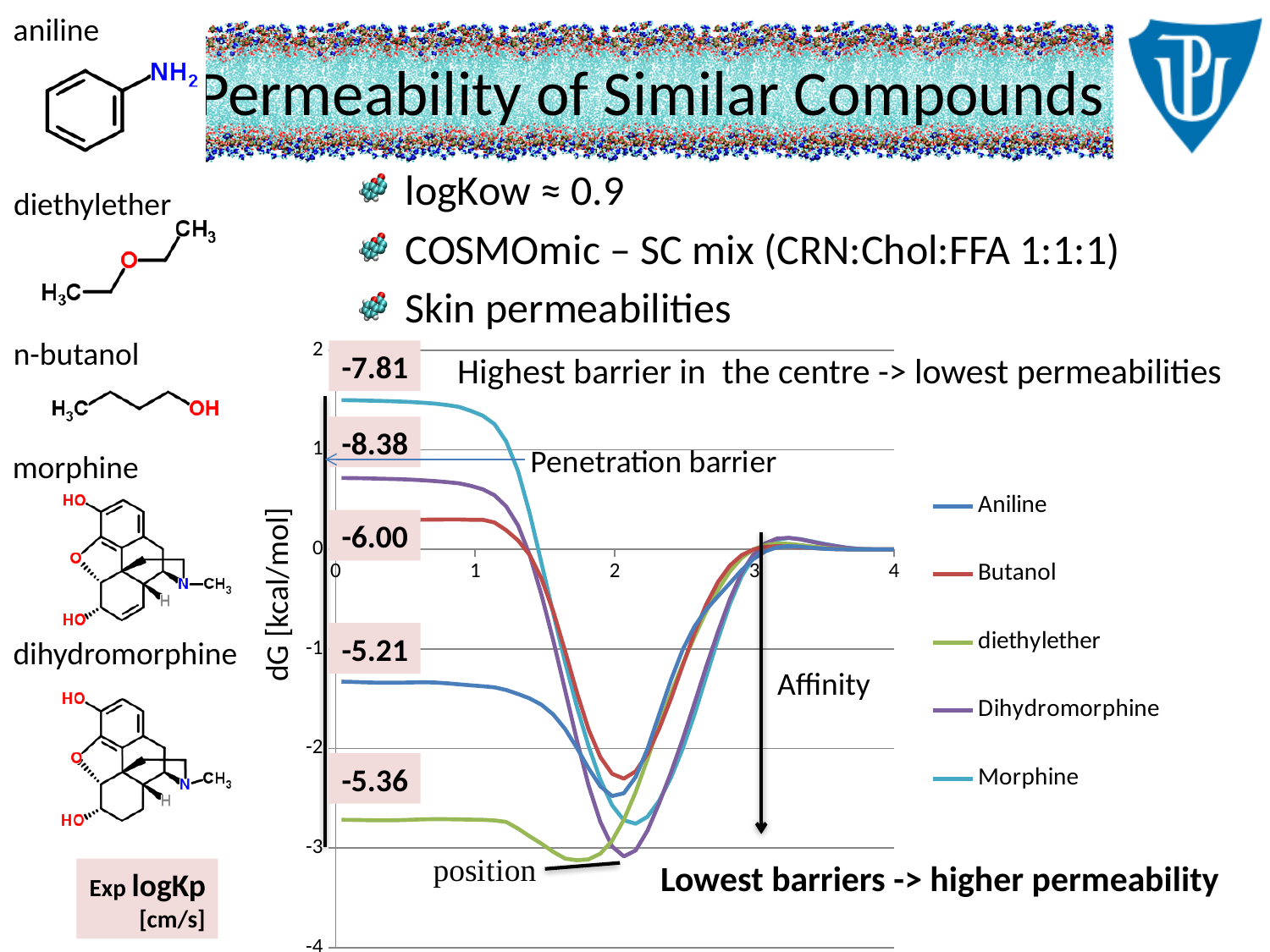
How many series does the chart legend list? 5 At x = 0, is the value for diethylether greater or less than -2? less At x = 0, is the value for Morphine greater or less than 1? greater Does the Morphine curve rise or fall between x = 1 and x = 2? fall Which series has the lowest value at x = 0? diethylether At x = 0, is the value for Butanol greater or less than 0? greater What kind of chart is shown on the slide? line chart Which series are listed in the chart legend? Aniline, Butanol, diethylether, Dihydromorphine, Morphine Which series has the highest value at x = 0? Morphine At x = 0, which is higher, Dihydromorphine or Aniline? Dihydromorphine What is the label of the vertical axis of the chart? dG [kcal/mol]